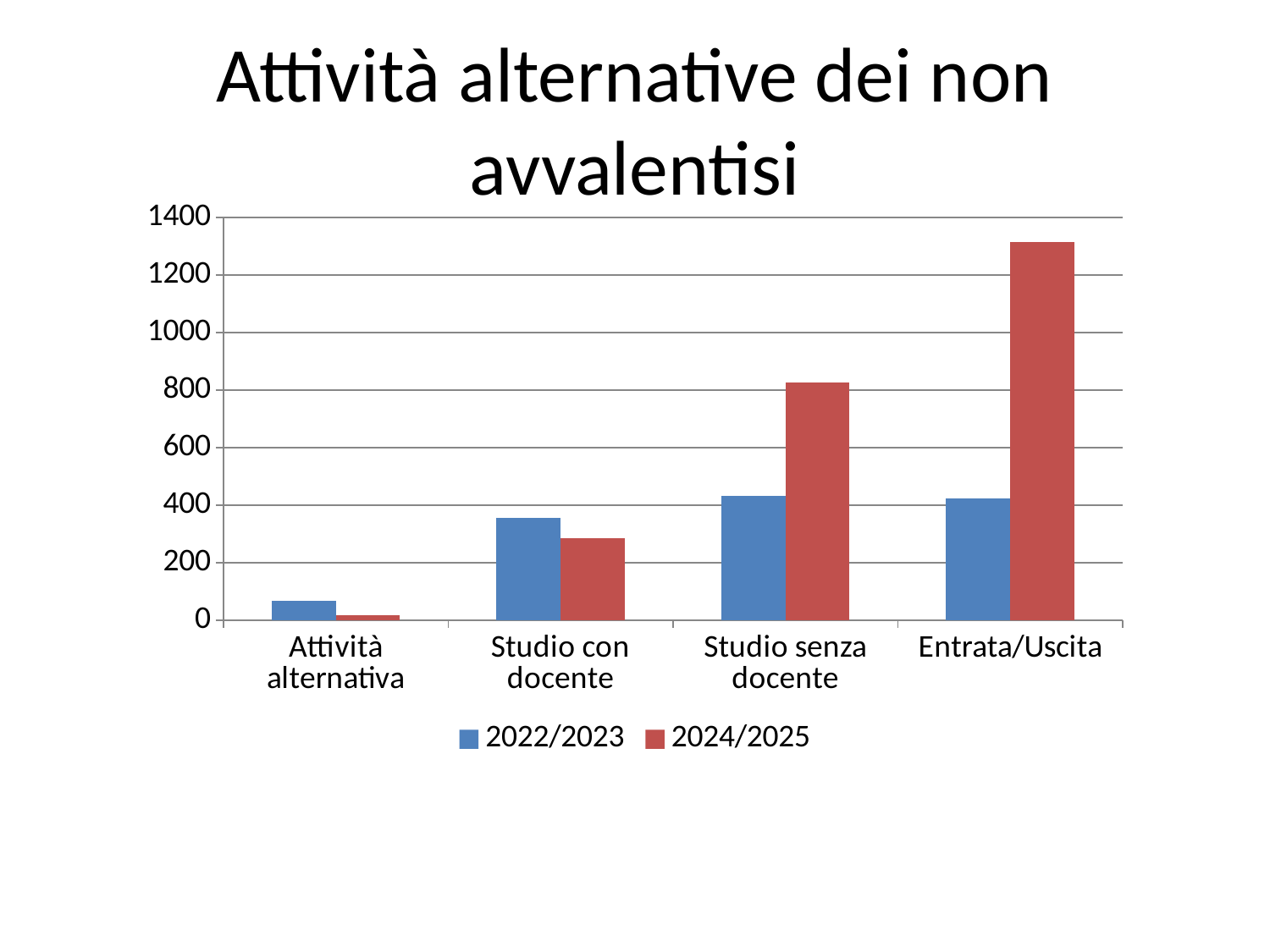
What is the title of the chart? Attività alternative dei non avvalentisi Is the 2024/2025 value for Studio senza docente greater or less than 600? greater Is the 2024/2025 value for Entrata/Uscita greater or less than 1200? greater Which category has the lowest value for 2022/2023? Attività alternativa Which category has the lowest value for 2024/2025? Attività alternativa How many series does the legend list? 2 How many categories are shown on the x axis? 4 Is the 2022/2023 value for Studio con docente greater or less than 400? less Which category has the highest value for 2024/2025? Entrata/Uscita For Studio con docente, which series has the larger value, 2022/2023 or 2024/2025? 2022/2023 What kind of chart is shown on the slide? bar chart